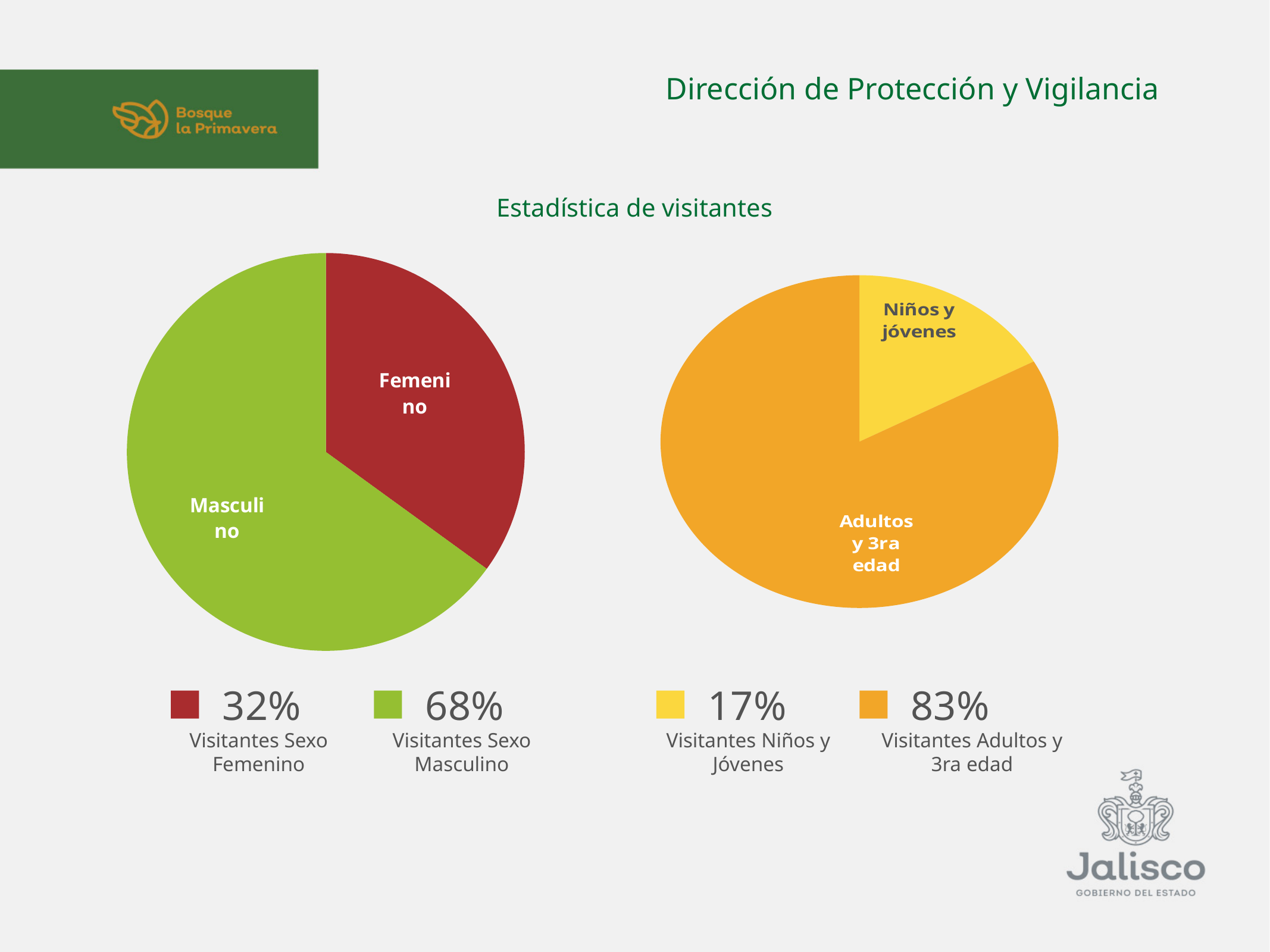
In the left pie chart (visitors by sex), what share of visitors is Femenino? 32% In the left pie chart (visitors by sex), what is the difference in percentage points between Masculino and Femenino? 36 In the right pie chart (visitors by age), what share of visitors is Adultos y 3ra edad? 83% In the right pie chart (visitors by age), which slice is the smallest? Niños y jóvenes In the right pie chart (visitors by age), what colour is the Niños y jóvenes slice? Yellow In the right pie chart (visitors by age), which is larger: Niños y jóvenes or Adultos y 3ra edad? Adultos y 3ra edad How many slices does the left pie chart (visitors by sex) have? 2 In the left pie chart (visitors by sex), what share of visitors is Masculino? 68% In the right pie chart (visitors by age), what share of visitors is Niños y jóvenes? 17% In the left pie chart (visitors by sex), which slice is the largest? Masculino What kind of chart is used for the visitor statistics on this slide? Pie chart In the right pie chart (visitors by age), what is the difference in percentage points between Adultos y 3ra edad and Niños y jóvenes? 66